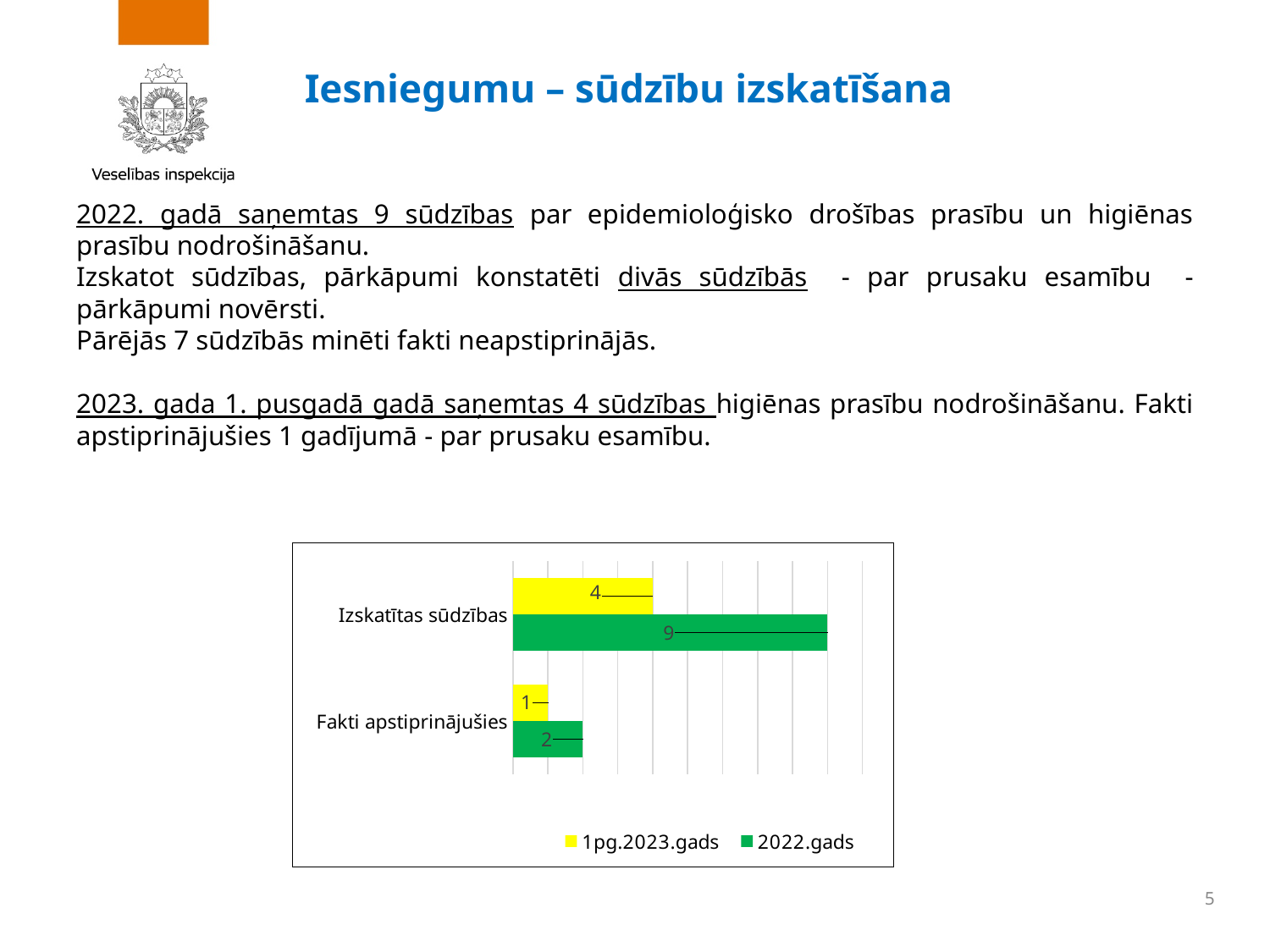
Which colour represents the 2022.gads series in the chart? Green What kind of chart is shown on the slide? Bar chart Which category has the highest value in the 2022.gads series? Izskatītas sūdzības What is the difference between the 2022.gads and 1pg.2023.gads values for Izskatītas sūdzības? 5 How many series does the legend list? 2 What is the value for Izskatītas sūdzības in the 2022.gads series? 9 Which is larger for Fakti apstiprinājušies: the 2022.gads value or the 1pg.2023.gads value? 2022.gads What is the value for Izskatītas sūdzības in the 1pg.2023.gads series? 4 What is the value for Fakti apstiprinājušies in the 1pg.2023.gads series? 1 Which category has the lowest value in the 1pg.2023.gads series? Fakti apstiprinājušies How many categories are shown on the chart? 2 What is the value for Fakti apstiprinājušies in the 2022.gads series? 2